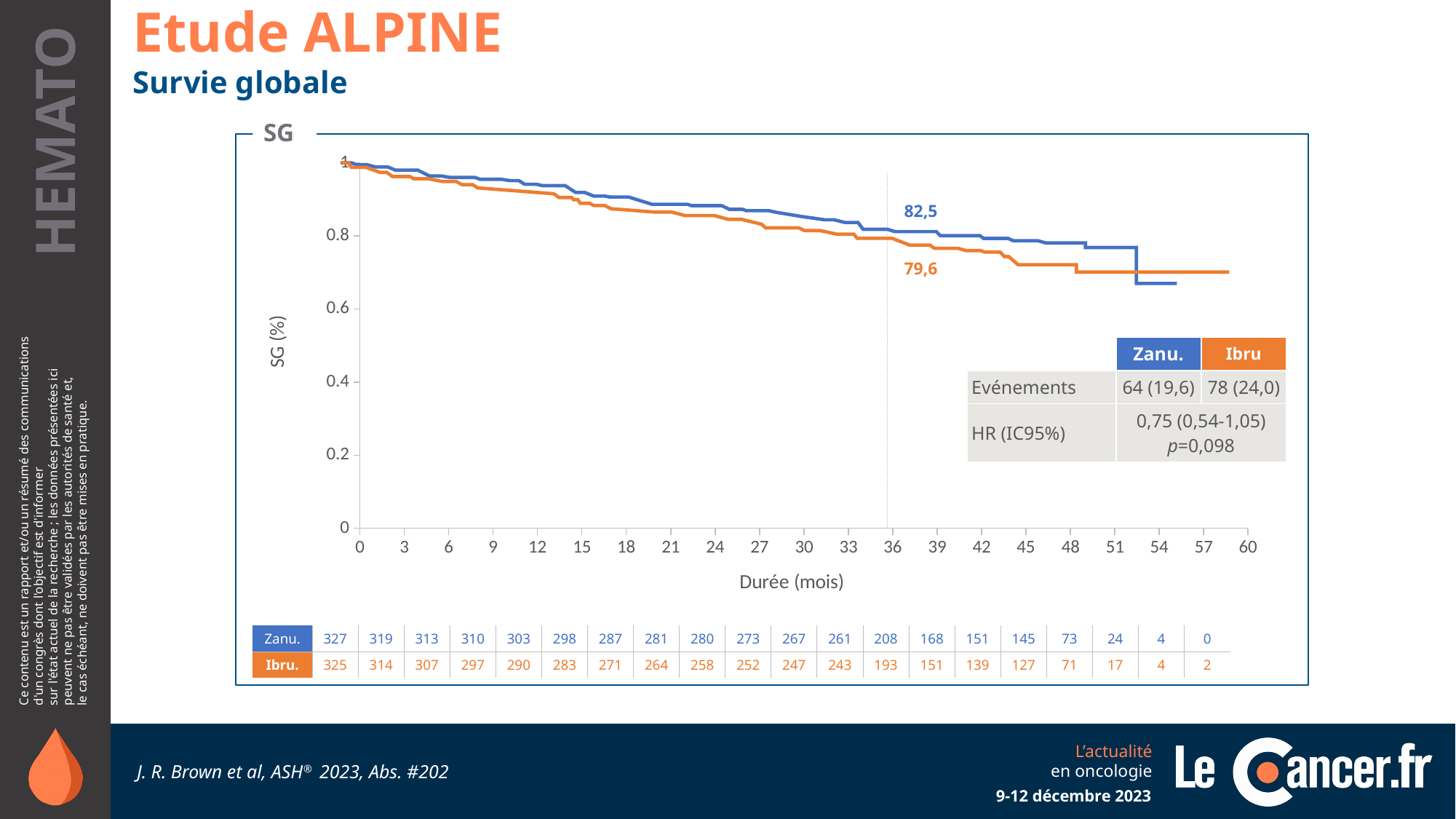
What colour is the line for the Zanu. arm? blue What is the title of the x axis of the chart? Durée (mois) What kind of chart is shown on the slide? line chart Is the value of the Ibru curve at 48 months greater or less than 0.8? less What is the labelled overall survival value for Zanu. at 36 months? 82,5 What is the difference between the labelled 36-month values for Zanu. (82,5) and Ibru (79,6)? 2,9 Do the survival curves rise or fall as duration in months increases? fall How many series (treatment arms) are plotted on the chart? 2 What is the labelled overall survival value for Ibru at 36 months? 79,6 Is the value of the Zanu. curve at 12 months greater or less than 0.8? greater In the number-at-risk table below the chart, how many Zanu. patients are at risk at month 0? 327 At 36 months, which arm has the higher labelled survival value, Zanu. or Ibru? Zanu.